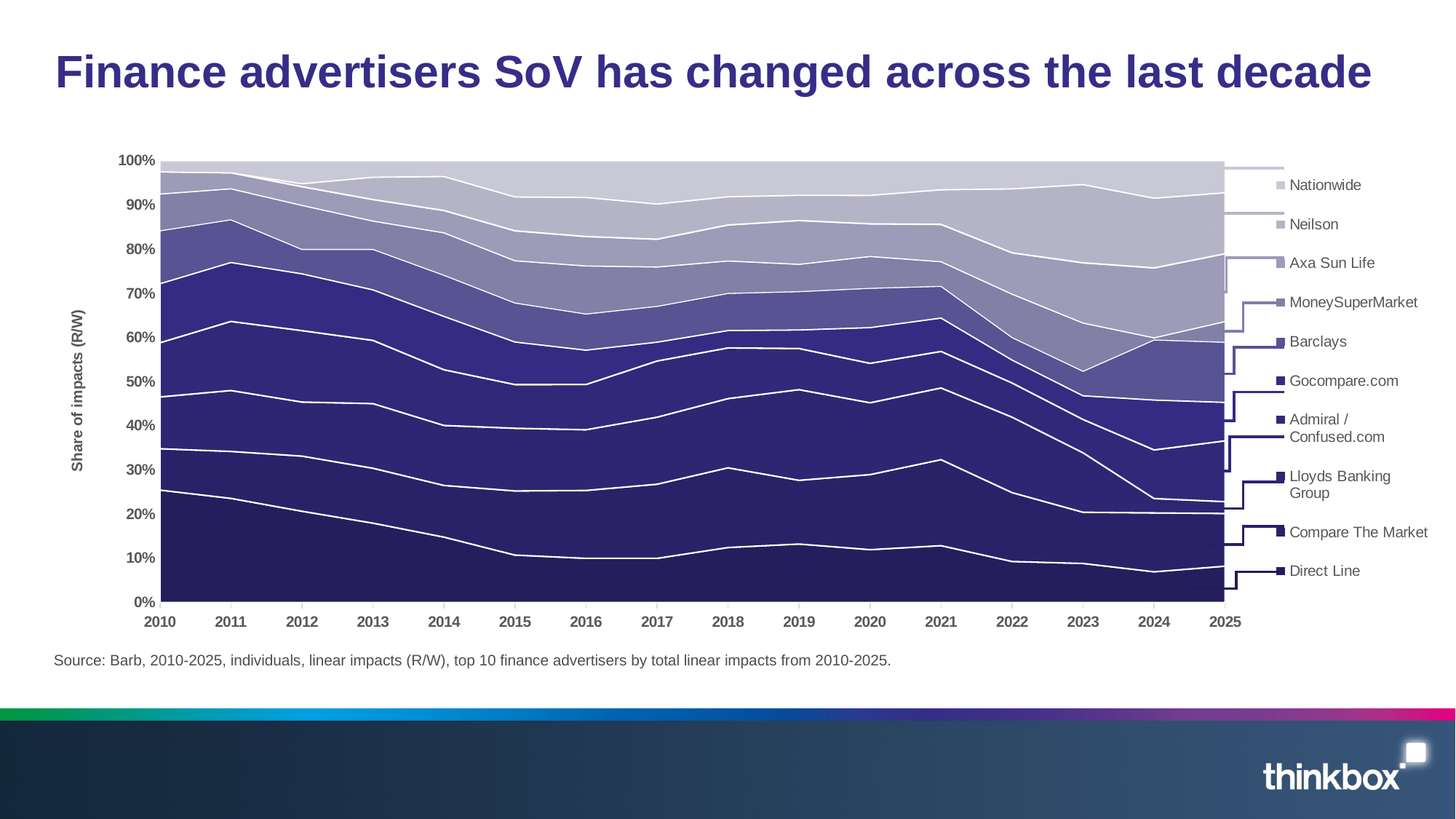
How many advertisers does the legend list? 10 Does the share for Direct Line rise or fall from 2010 to 2025? Fall How many years are plotted along the x axis? 16 Is the share for Direct Line in 2015 greater or less than 20%? less Is the share for Direct Line in 2024 greater or less than 10%? less Is the share for Direct Line in 2010 greater or less than 20%? greater What kind of chart is shown on the slide? Stacked area chart What is the title of the chart on the slide? Finance advertisers SoV has changed across the last decade In which year is the share for Direct Line highest? 2010 Which is larger, the share for Direct Line in 2010 or in 2025? 2010 What is the label on the y axis? Share of impacts (R/W) Does the share for Nationwide rise or fall from 2010 to 2025? Rise